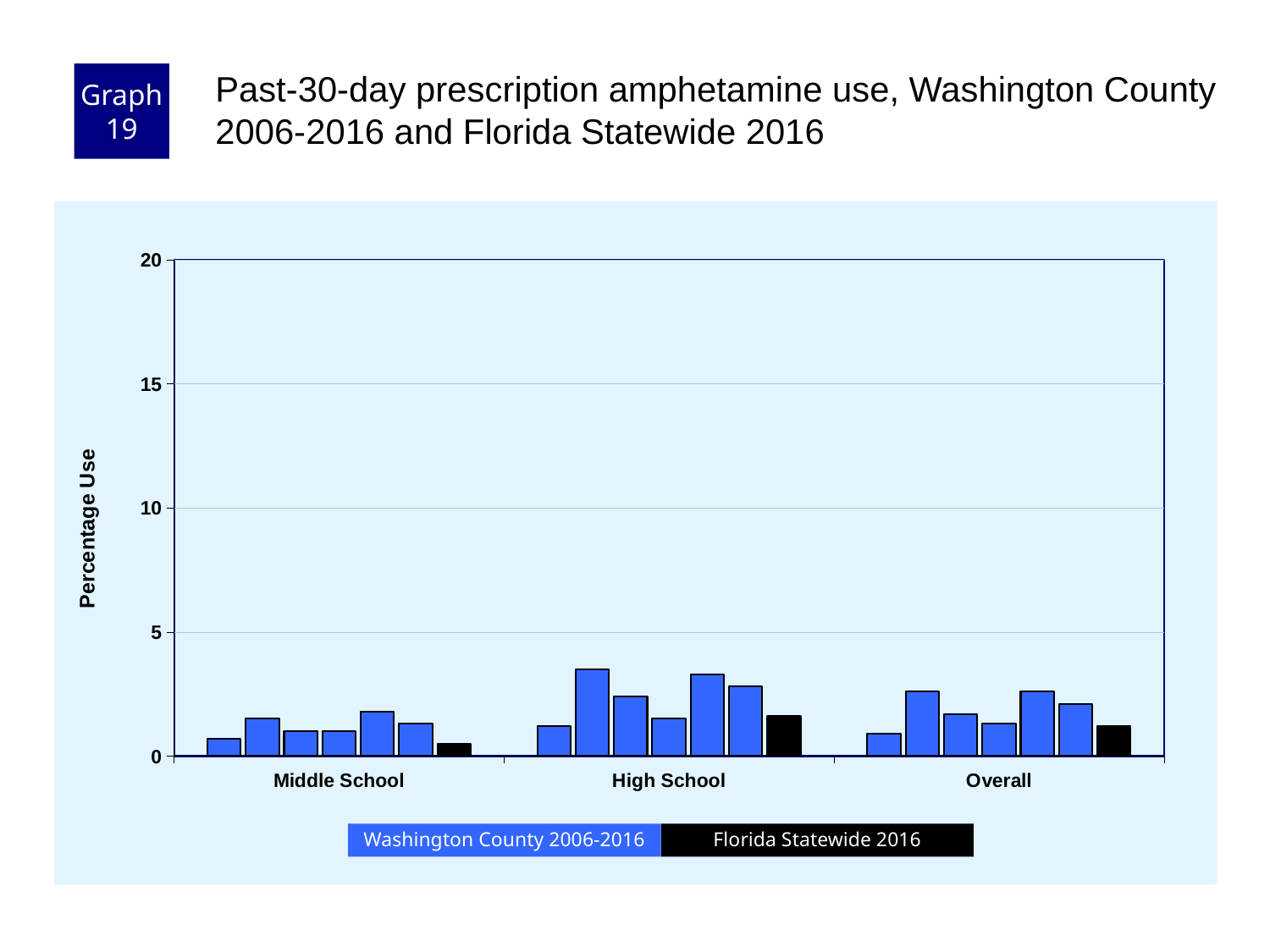
Is the Florida Statewide 2016 value for Middle School greater or less than 5? less Which series is shown in black in the legend? Florida Statewide 2016 Is the Florida Statewide 2016 value larger for Overall or for Middle School? Overall How many series does the legend list? 2 Is the highest Washington County bar in the High School group greater or less than 5? less How many categories are shown on the x axis? 3 Is the Florida Statewide 2016 value larger for High School or for Middle School? High School What is the label of the y axis? Percentage Use Which category has the tallest bar overall? High School Which category has the lowest Florida Statewide 2016 bar? Middle School What kind of chart is shown on the slide? bar chart Is the Florida Statewide 2016 value for High School greater or less than 5? less